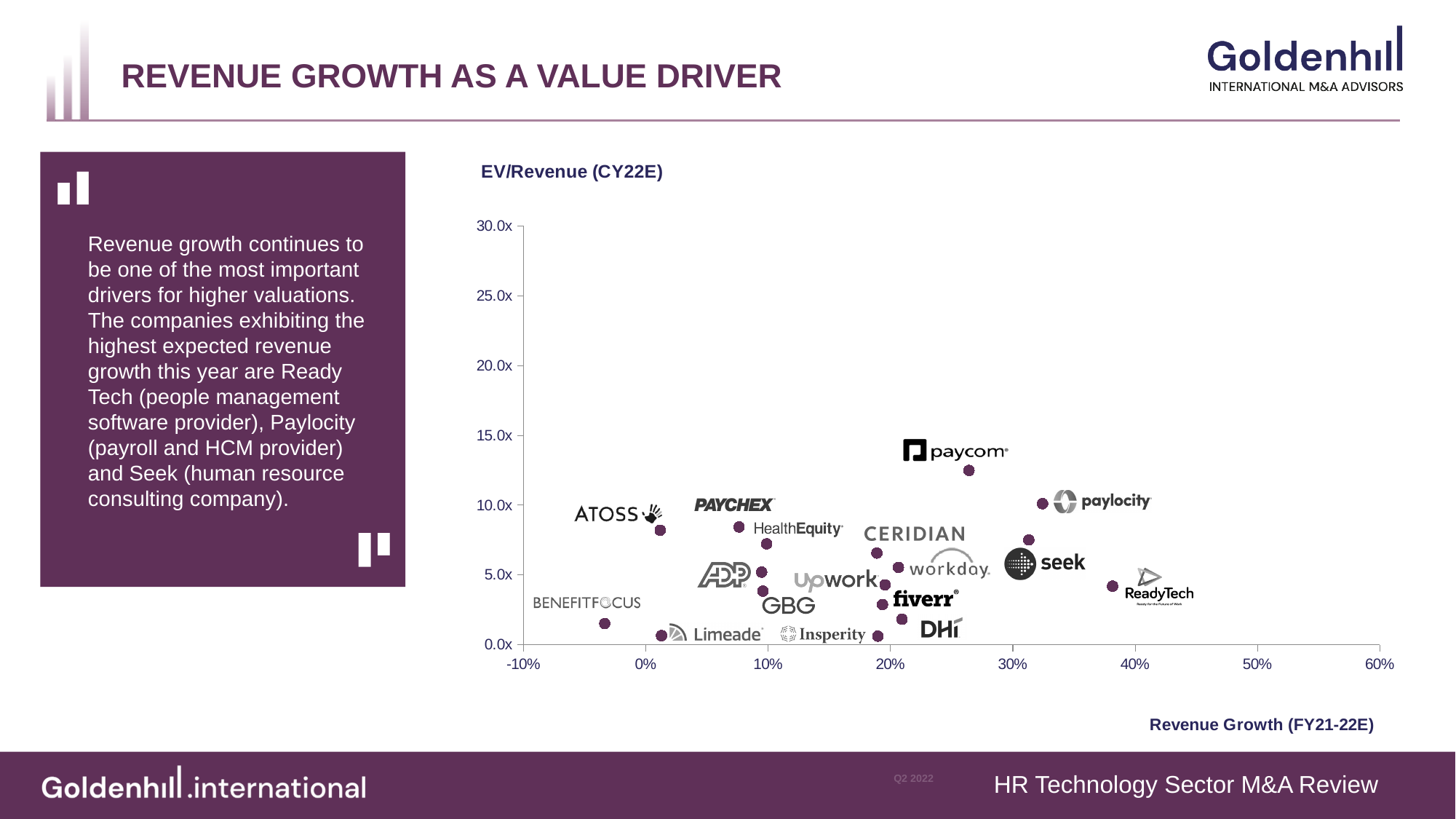
What kind of chart is shown on the slide? Scatter chart Is the revenue growth for Paycom greater or less than 20%? greater Which has the higher EV/Revenue multiple, Paychex or ADP? Paychex Which company has the highest EV/Revenue (CY22E) multiple on the chart? Paycom Which company has the lowest revenue growth (FY21-22E) on the chart? Benefitfocus Which company has the highest revenue growth (FY21-22E) on the chart? ReadyTech Is the EV/Revenue multiple for Paycom greater or less than 10.0x? greater What is the label of the horizontal axis of the chart? Revenue Growth (FY21-22E) Which has the higher EV/Revenue multiple, Paycom or Paylocity? Paycom Is the revenue growth for ReadyTech greater or less than 30%? greater